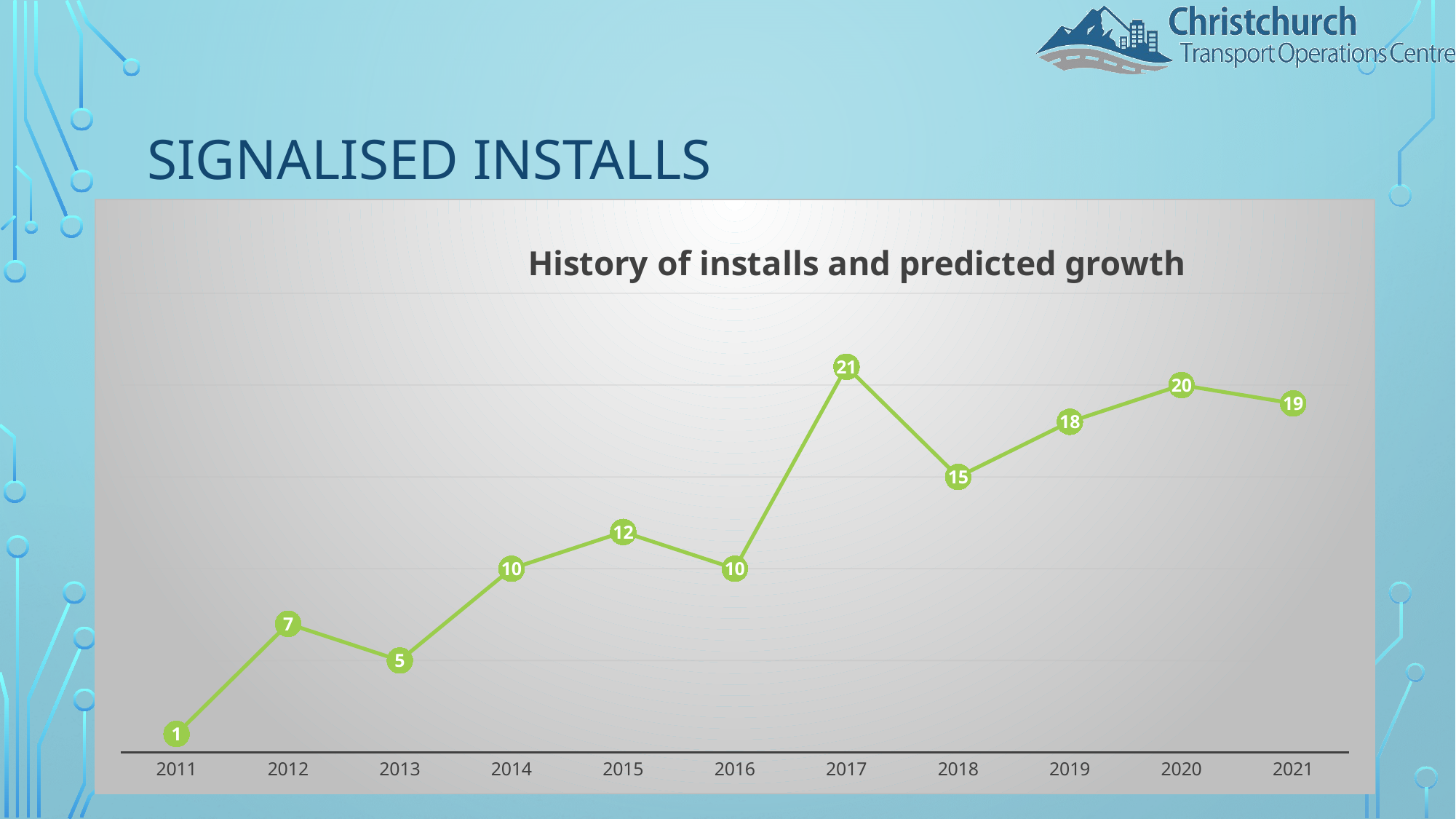
What is the difference between the values for 2017 and 2018? 6 What is the value for 2017? 21 Which year has the highest value? 2017 Which year has the lowest value? 2011 What is the difference between the values for 2020 and 2012? 13 Do the values rise or fall from 2011 to 2012? Rise What is the value for 2011? 1 How many years are plotted on the x axis? 11 What kind of chart is shown? Line chart Which is larger, the value for 2015 or the value for 2016? 2015 What is the value for 2019? 18 What is the title of the chart? History of installs and predicted growth